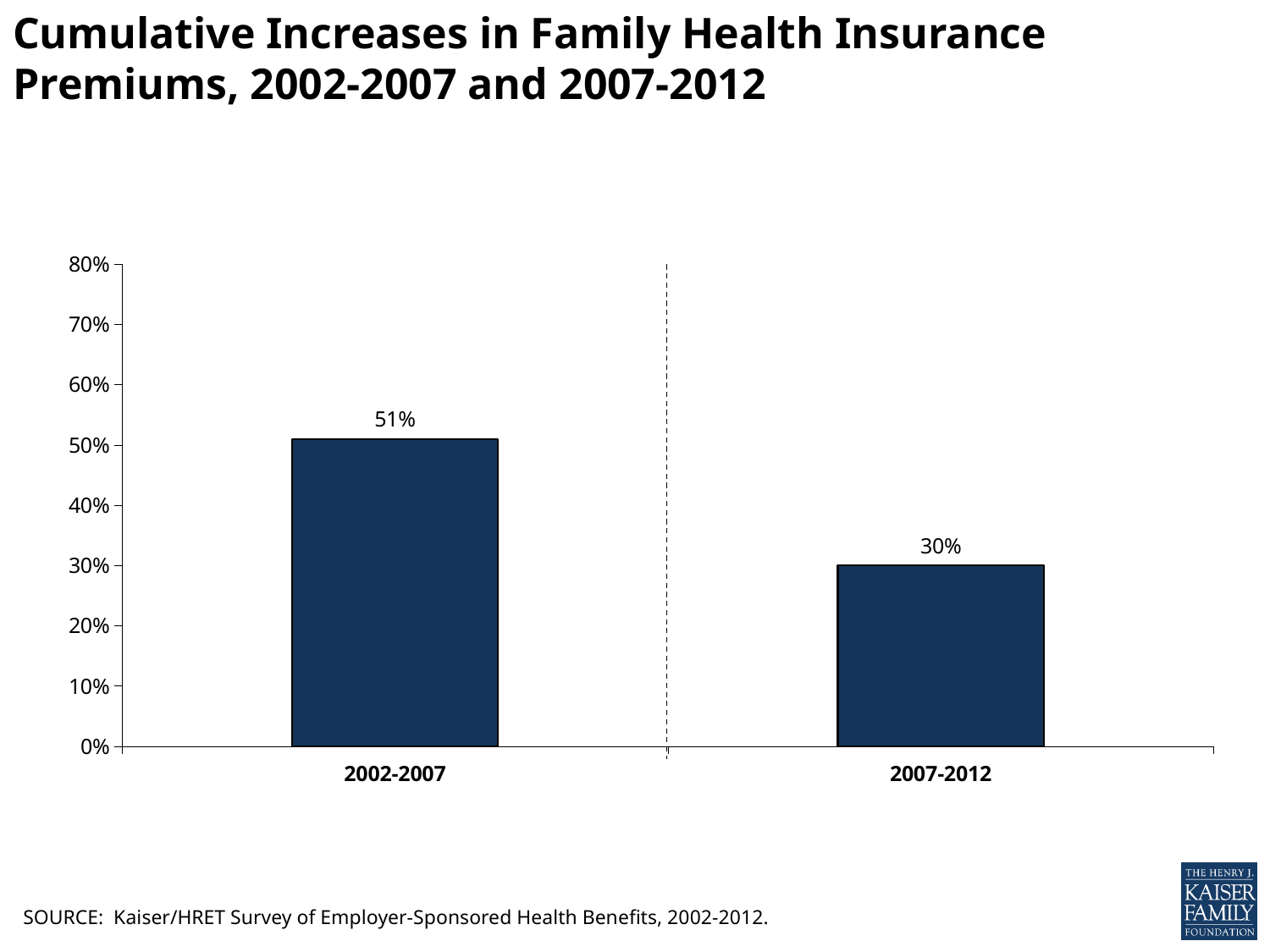
What is the difference between the cumulative increase for 2002-2007 and for 2007-2012? 21 percentage points What kind of chart is shown on the slide? Bar chart What is the cumulative increase in family health insurance premiums for 2002-2007? 51% What is the cumulative increase in family health insurance premiums for 2007-2012? 30% Do the values rise or fall from the 2002-2007 period to the 2007-2012 period? fall Which period shows the lower cumulative increase in premiums? 2007-2012 Is the cumulative increase for 2007-2012 larger or smaller than that for 2002-2007? smaller Is the value for 2002-2007 greater or less than 40%? greater Which period shows the higher cumulative increase in premiums? 2002-2007 Is the value for 2007-2012 greater or less than 40%? less How many periods are shown on the chart? 2 What is the highest value shown on the vertical axis of the chart? 80%